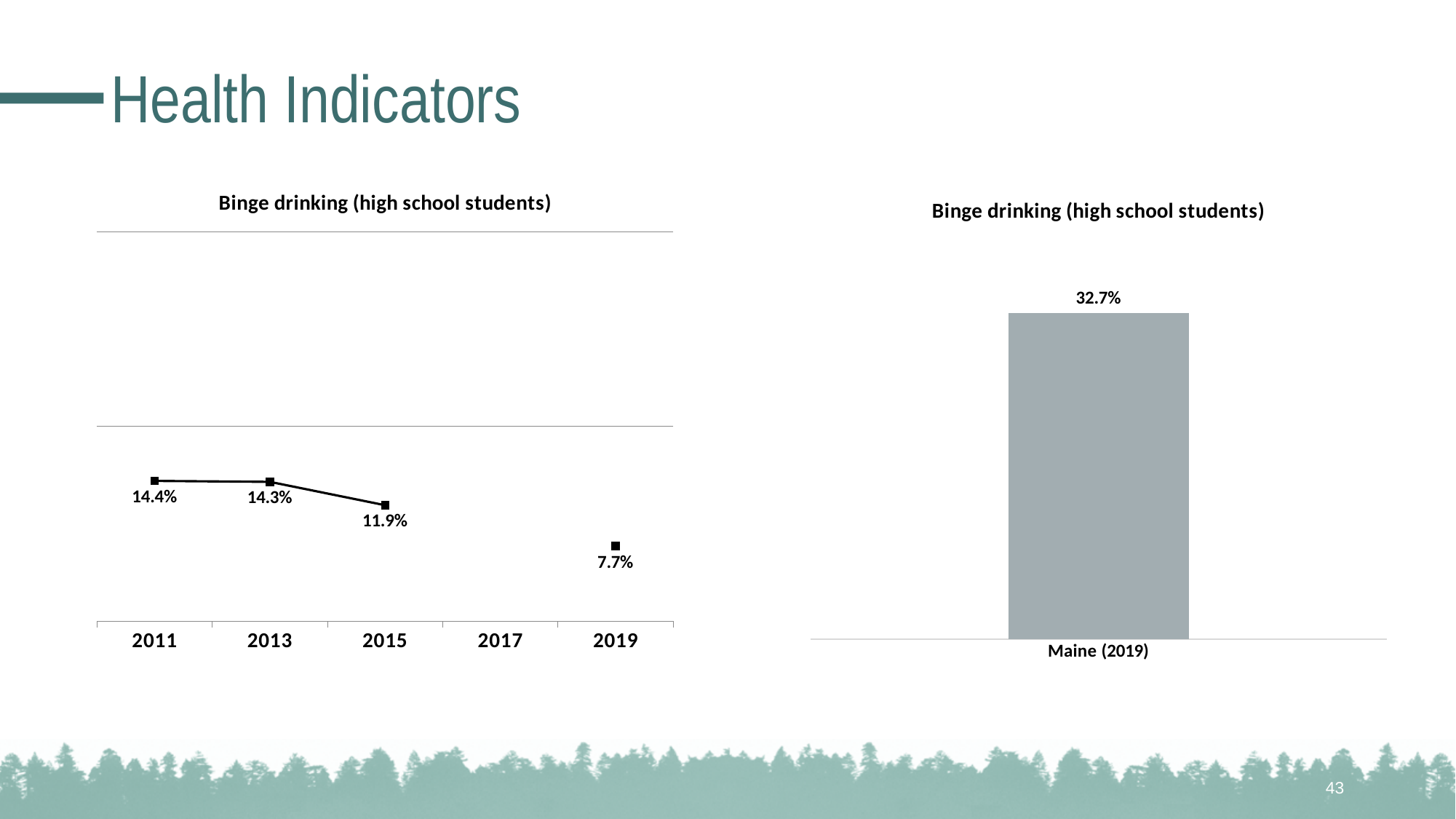
In the left chart, which year has the lowest value? 2019 In the left chart, what is the value for 2015? 11.9% In the left chart, what is the value for 2013? 14.3% Is the 2019 value in the left chart larger or smaller than the Maine (2019) value in the right chart? smaller In the left chart, which year has the highest value? 2011 In the right chart, what is the value for Maine (2019)? 32.7% In the left chart, what is the binge drinking value for 2011? 14.4% In the left chart, what is the value for 2019? 7.7% In the left chart, what is the difference between the 2011 and 2019 values? 6.7 percentage points In the left chart, which year on the x axis has no data point plotted? 2017 In the left chart, do the values rise or fall from 2011 to 2019? fall What kind of chart is the right chart? bar chart